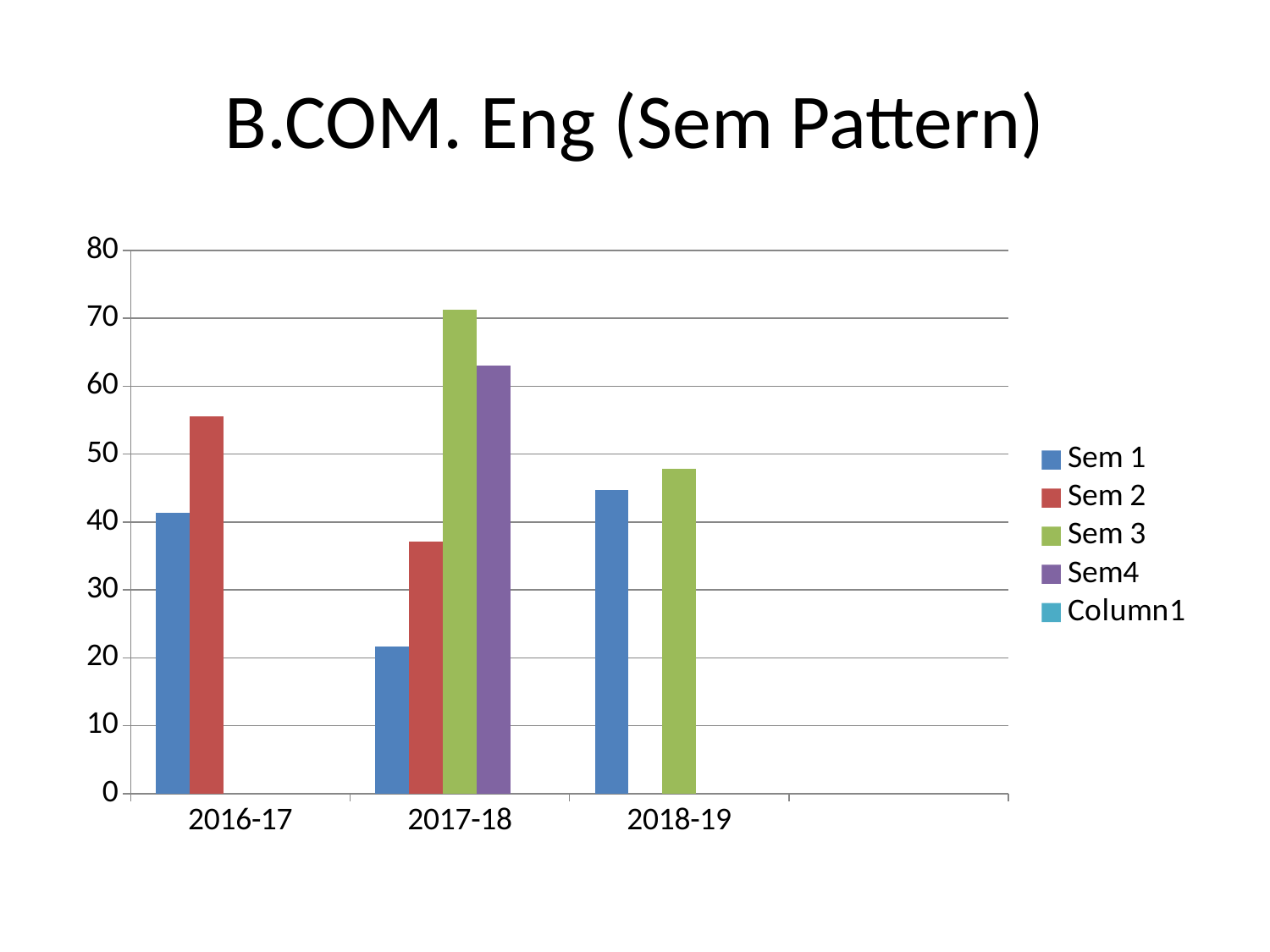
What is the title of the chart? B.COM. Eng (Sem Pattern) Is the value for Sem 2 in 2016-17 greater or less than 50? greater How many entries does the legend list? 5 In which year does Sem 1 have its lowest value? 2017-18 Is the value for Sem 1 in 2017-18 greater or less than 30? less What kind of chart is shown on the slide? bar chart Is the value for Sem 3 in 2018-19 greater or less than 50? less How many academic years are labelled on the x axis? 3 Does the value for Sem 1 rise or fall from 2016-17 to 2017-18? fall Which series has the tallest bar in the whole chart? Sem 3 In 2016-17, which is larger, Sem 1 or Sem 2? Sem 2